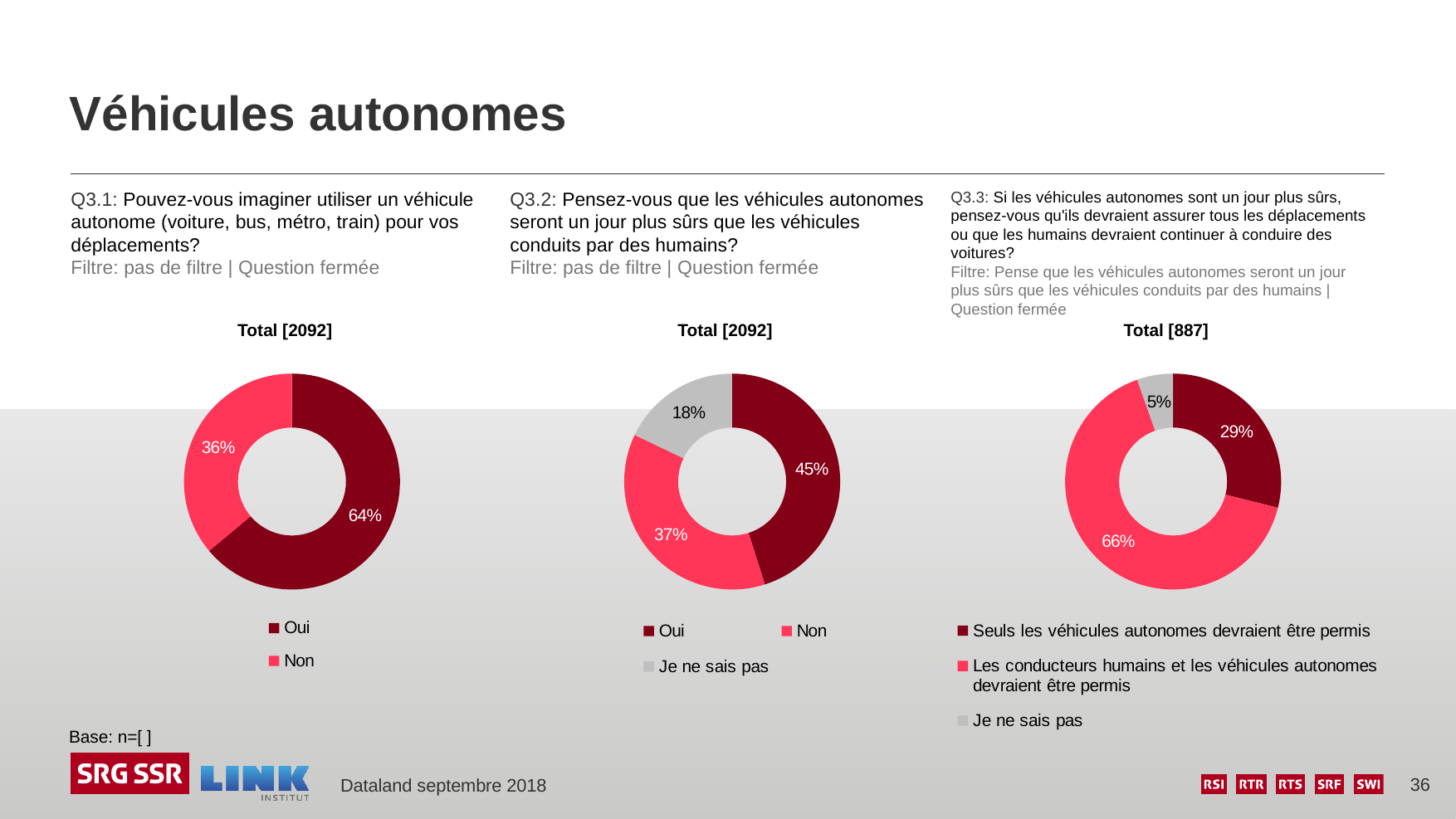
In the right chart (Q3.3), which response has the largest share? Les conducteurs humains et les véhicules autonomes devraient être permis What is the total base shown above the right chart (Q3.3)? Total [887] In the right chart (Q3.3), what percentage chose "Seuls les véhicules autonomes devraient être permis"? 29% In the left chart (Q3.1), what is the difference between the "Oui" and "Non" shares? 28 percentage points In the left chart (Q3.1), what percentage answered "Oui"? 64% In the middle chart (Q3.2), what percentage answered "Je ne sais pas"? 18% What type of chart is used for Q3.1, Q3.2 and Q3.3? Donut (pie) chart In the left chart (Q3.1), what percentage answered "Non"? 36% In the middle chart (Q3.2), which response has the smallest share? Je ne sais pas In the middle chart (Q3.2), how many response categories are shown? 3 In the middle chart (Q3.2), which response has the largest share? Oui In the right chart (Q3.3), is the share for "Je ne sais pas" larger or smaller than the share for "Seuls les véhicules autonomes devraient être permis"? smaller